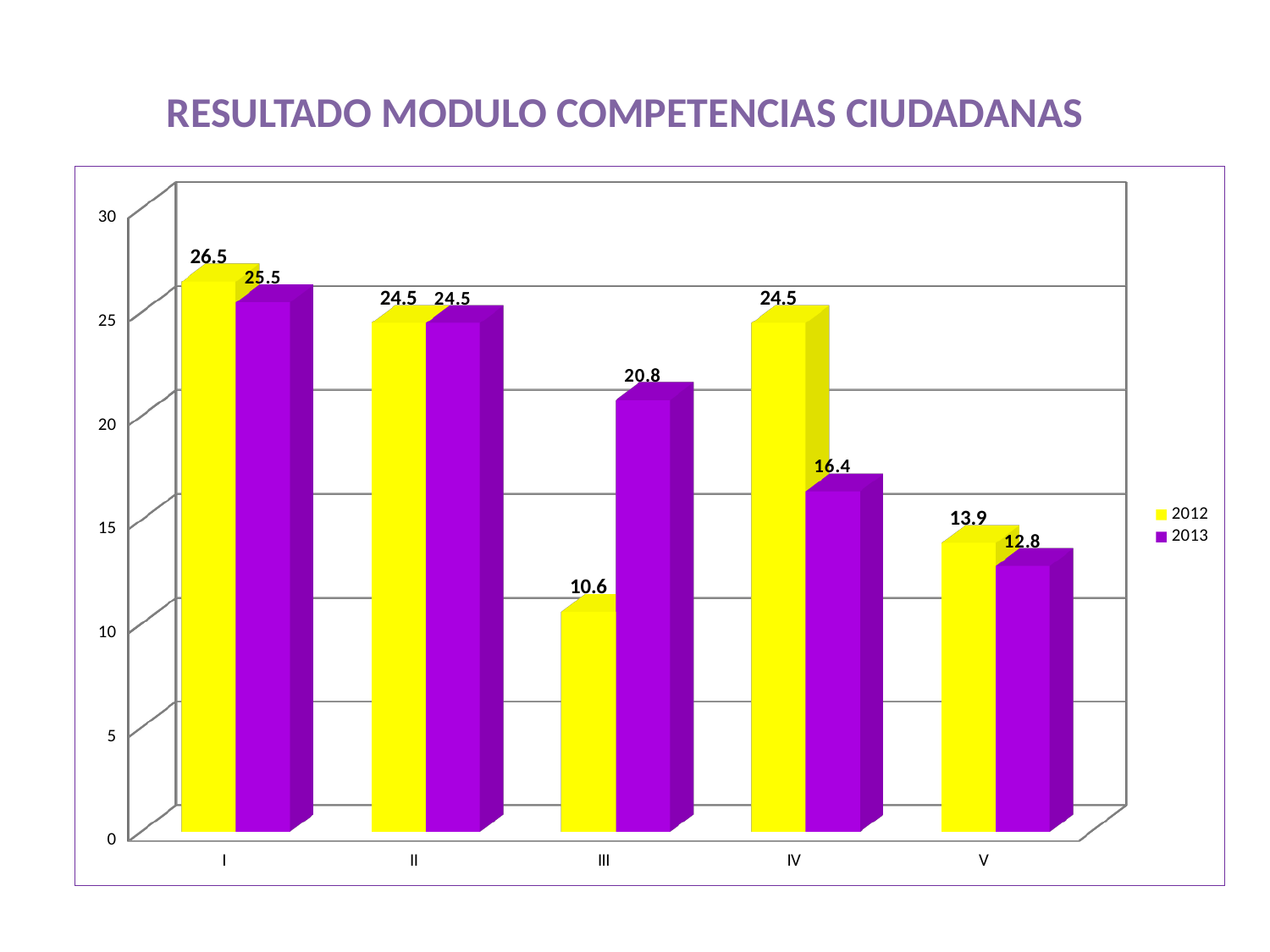
What is the 2013 value for category III? 20.8 What is the difference between the 2013 and 2012 values for category III? 10.2 Which category has the lowest 2013 value? V What is the difference between the 2012 and 2013 values for category IV? 8.1 What is the 2012 value for category I? 26.5 What is the 2013 value for category IV? 16.4 What is the title of the chart? RESULTADO MODULO COMPETENCIAS CIUDADANAS How many series does the legend list? 2 Which category has the lowest 2012 value? III Which category has the highest 2012 value? I How many categories are shown on the x axis? 5 Which is larger for category V, the 2012 value or the 2013 value? 2012